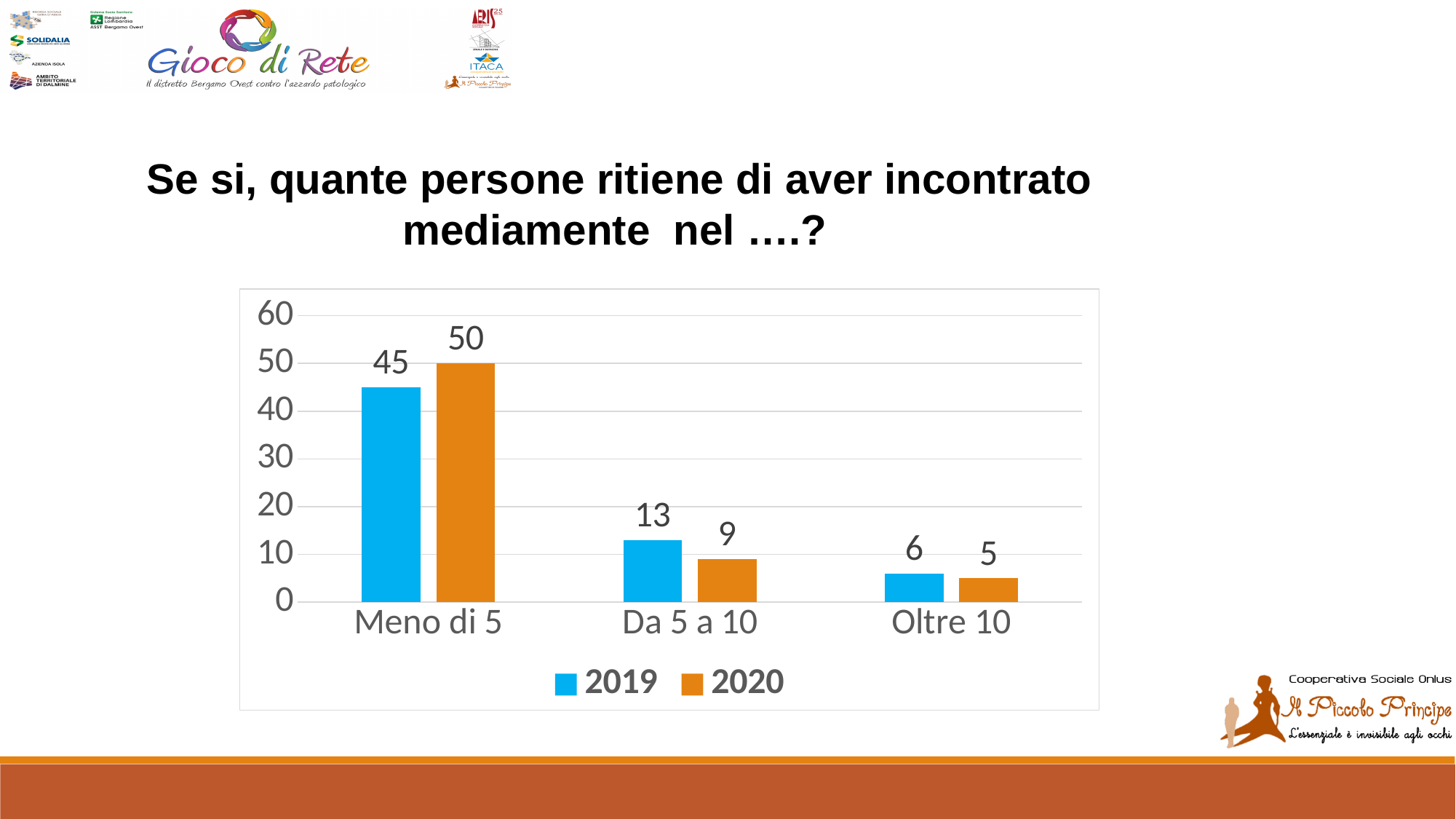
How many categories are shown on the x axis? 3 What is the value for 2020 in the "Oltre 10" category? 5 Which category has the highest value for 2020? Meno di 5 Do the 2019 values rise or fall from "Meno di 5" to "Oltre 10"? Fall What is the difference between the 2019 and 2020 values for "Da 5 a 10"? 4 What is the value for 2019 in the "Meno di 5" category? 45 How many series does the legend list? 2 What kind of chart is shown on the slide? Bar chart Which category has the lowest value for 2019? Oltre 10 What is the value for 2020 in the "Da 5 a 10" category? 9 Which is larger for "Oltre 10": the 2019 value or the 2020 value? 2019 What is the difference between the 2020 and 2019 values for "Meno di 5"? 5